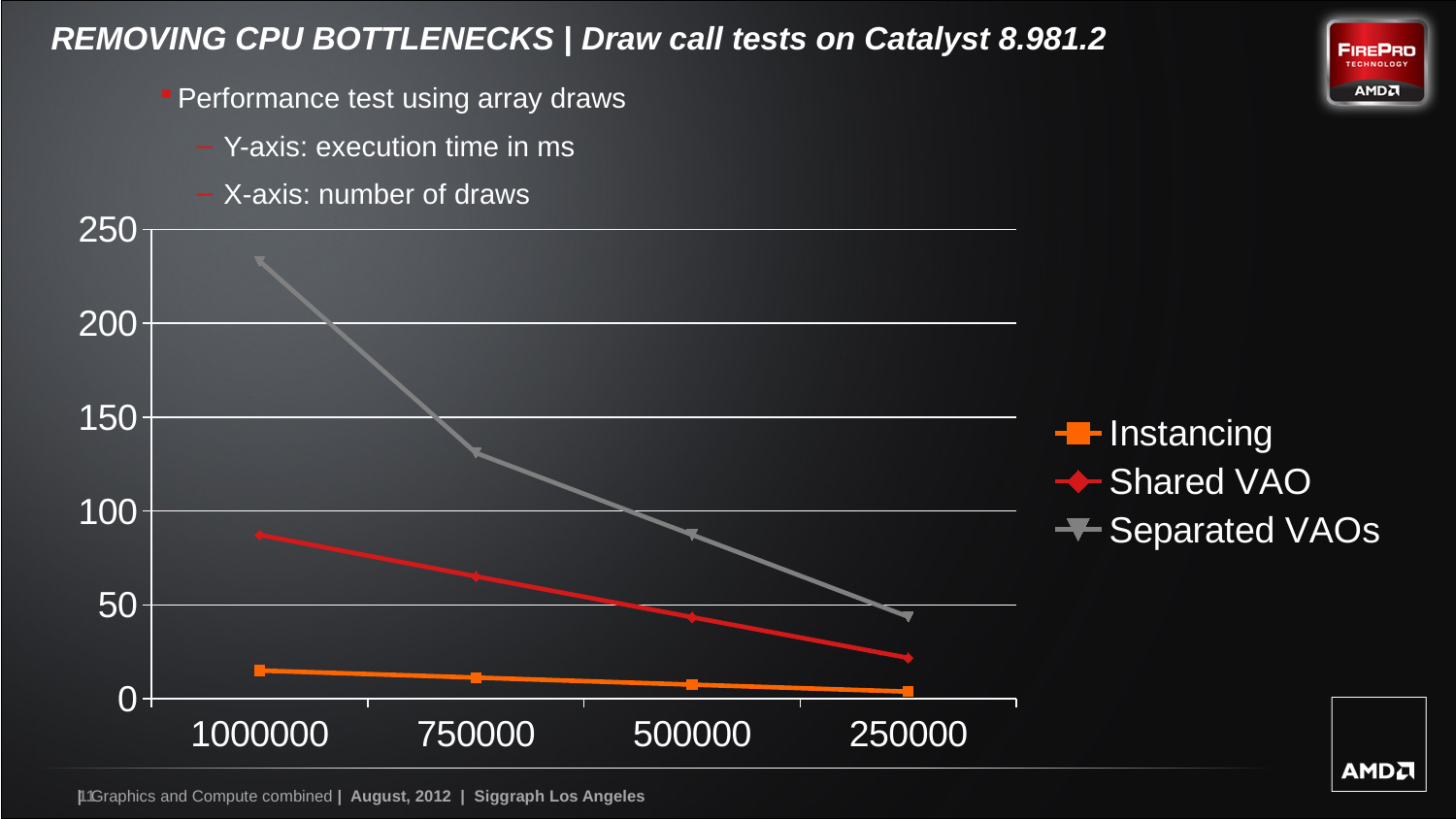
Is the value for Instancing at 1000000 draws greater or less than 50? less Do the execution times rise or fall moving from 1000000 draws to 250000 draws along the x axis? fall Which is larger at 750000 draws: Shared VAO or Instancing? Shared VAO Is the value for Shared VAO at 1000000 draws greater or less than 100? less Is the value for Separated VAOs at 750000 draws greater or less than 100? greater How many points along the x axis (number of draws) are plotted for each series? 4 Which legend entry is drawn in orange? Instancing Which series has the highest execution time at 1000000 draws? Separated VAOs Which series has the lowest execution time across all draw counts? Instancing How many series does the legend list? 3 What kind of chart is shown on the slide? line chart